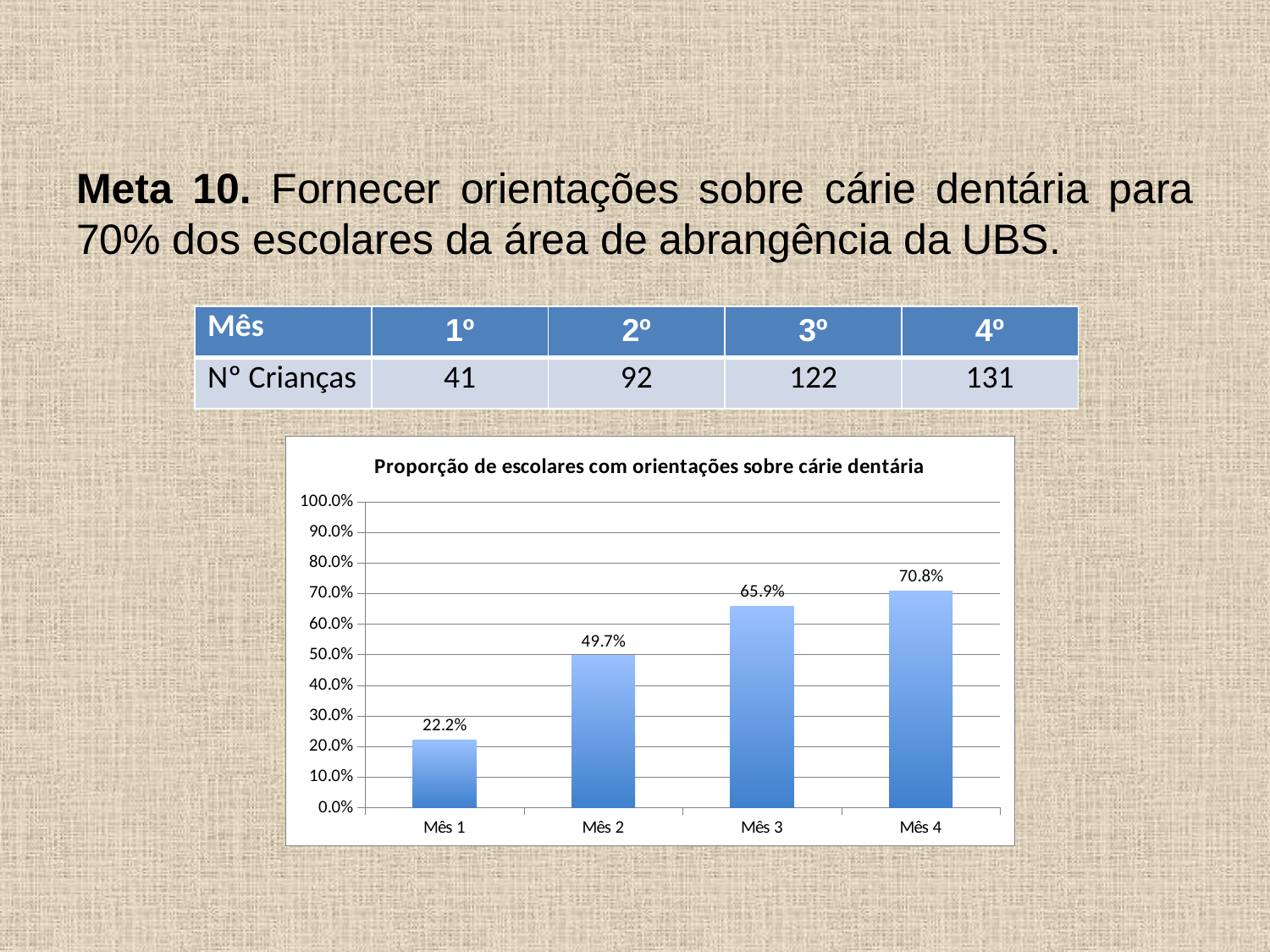
Do the values rise or fall from Mês 1 to Mês 4? rise What kind of chart is shown? bar chart Which is larger, the value for Mês 2 or the value for Mês 3? Mês 3 What is the value for Mês 2? 49.7% Which month has the highest value? Mês 4 What is the value for Mês 4? 70.8% What is the difference between the values for Mês 4 and Mês 1? 48.6% What is the value for Mês 3? 65.9% How many months are shown on the chart? 4 Is the value for Mês 2 greater or less than 40.0%? greater Which month has the lowest value? Mês 1 What is the value for Mês 1? 22.2%